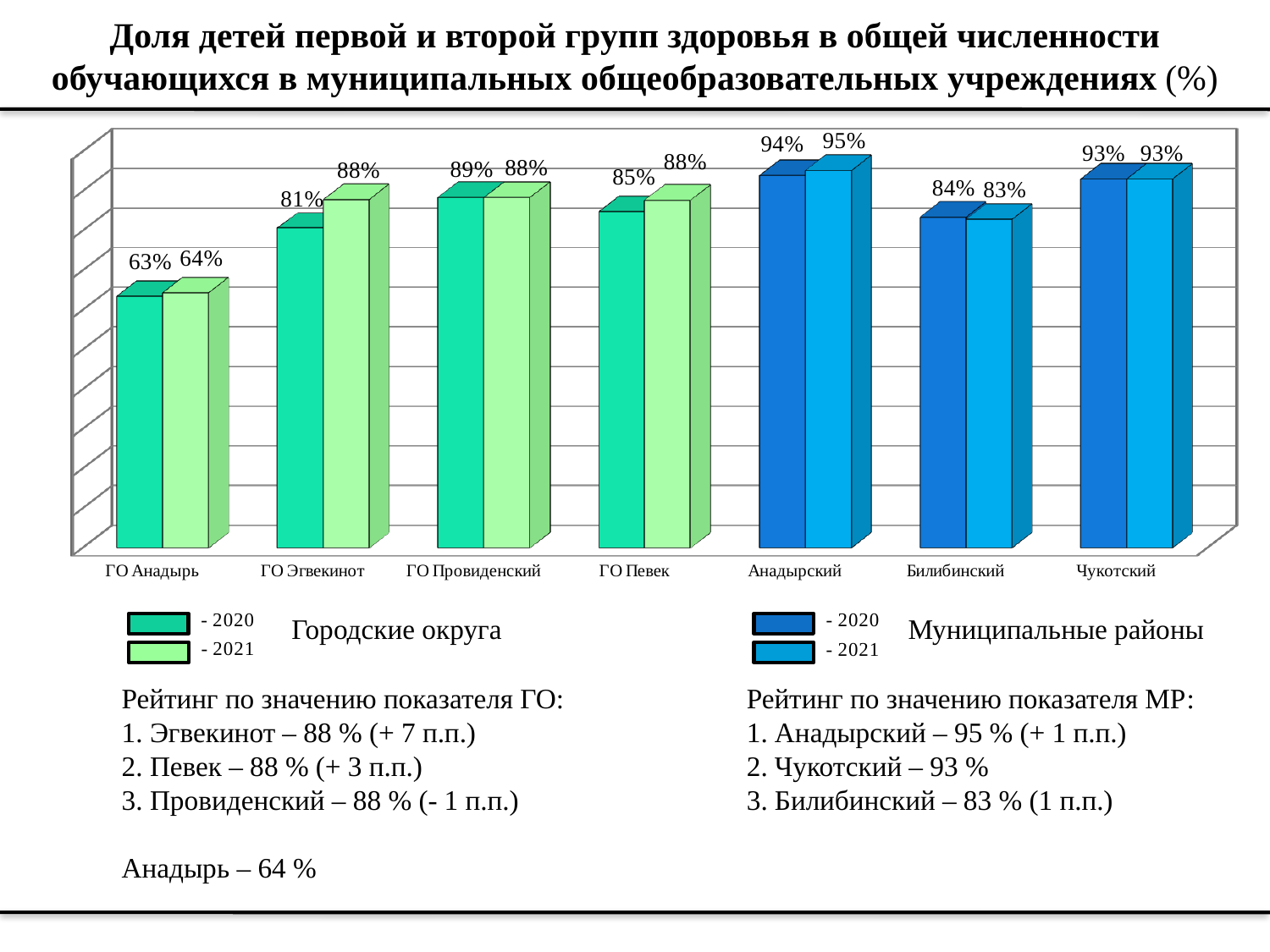
Which category has the lowest value in 2020? ГО Анадырь Which category has the highest value in 2021? Анадырский What is the value for ГО Эгвекинот in 2020? 81% What is the value for Билибинский in 2020? 84% How many categories are shown on the x axis? 7 What is the value for Анадырский in 2021? 95% Which is larger: the 2020 value for ГО Провиденский or the 2020 value for ГО Певек? ГО Провиденский What is the difference between the 2021 and 2020 values for ГО Эгвекинот? 7 percentage points What is the value for ГО Анадырь in 2021? 64% What colour are the bars for the municipal districts (Муниципальные районы)? Blue What kind of chart is shown on the slide? Bar chart Which years does the legend list as series? 2020 and 2021